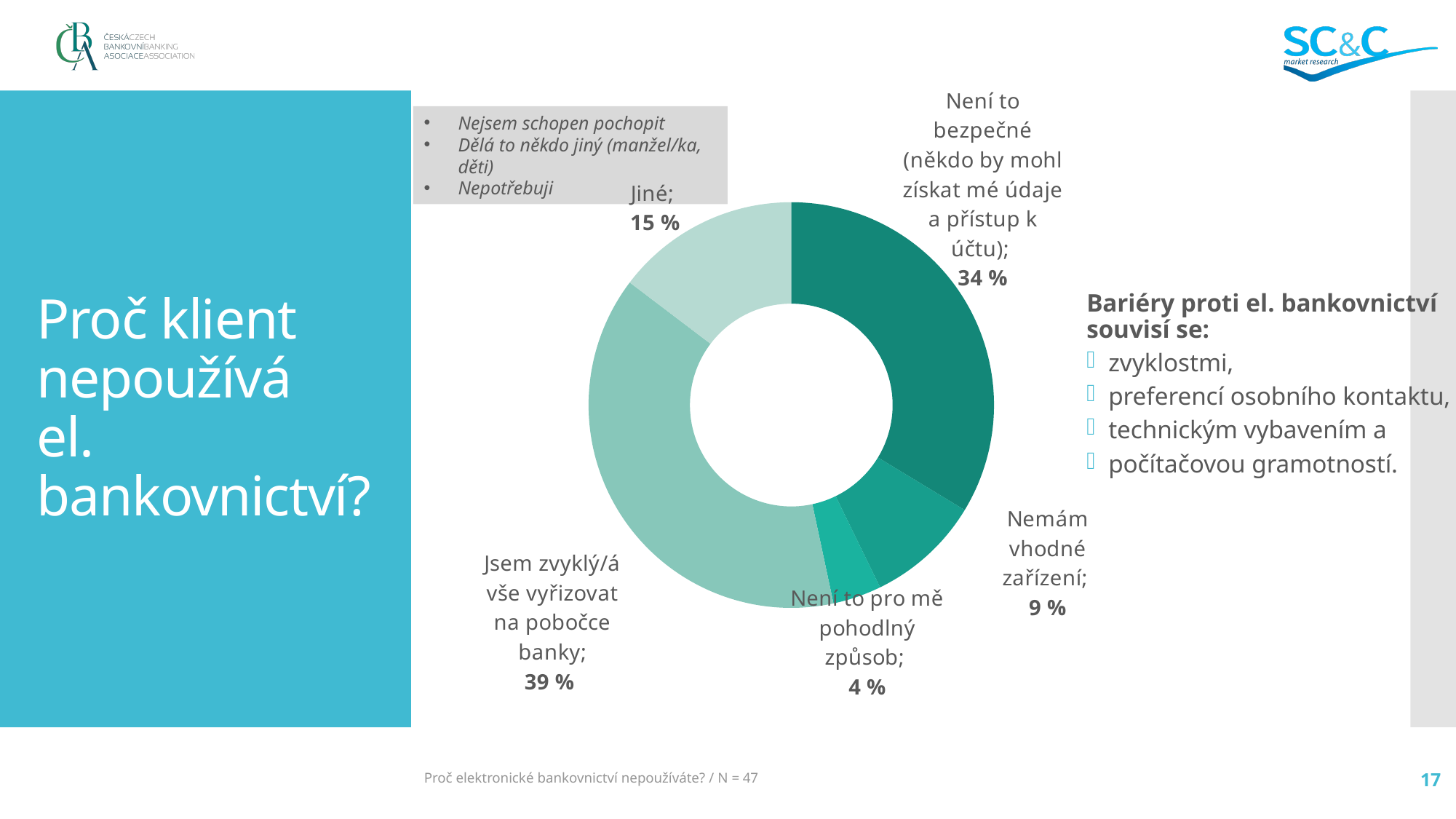
How many categories (slices) does the chart have? 5 What share of respondents say they are used to handling everything at the bank branch (Jsem zvyklý/á vše vyřizovat na pobočce banky)? 39 % Which reason has the smallest share in the chart? Není to pro mě pohodlný způsob How many percentage points larger is 'Jsem zvyklý/á vše vyřizovat na pobočce banky' than 'Není to bezpečné'? 5 percentage points What share of respondents fall into the 'Jiné' (other) category? 15 % What share of respondents say it is not a convenient way for them (Není to pro mě pohodlný způsob)? 4 % What kind of chart is shown on the slide? Donut (pie) chart Which is larger: the share for 'Jiné' or the share for 'Nemám vhodné zařízení'? Jiné According to the footnote, how many respondents (N) answered the question shown in the chart? N = 47 Which reason has the largest share in the chart? Jsem zvyklý/á vše vyřizovat na pobočce banky What share of respondents say electronic banking is not safe (Není to bezpečné)? 34 % What share of respondents say they do not have a suitable device (Nemám vhodné zařízení)? 9 %